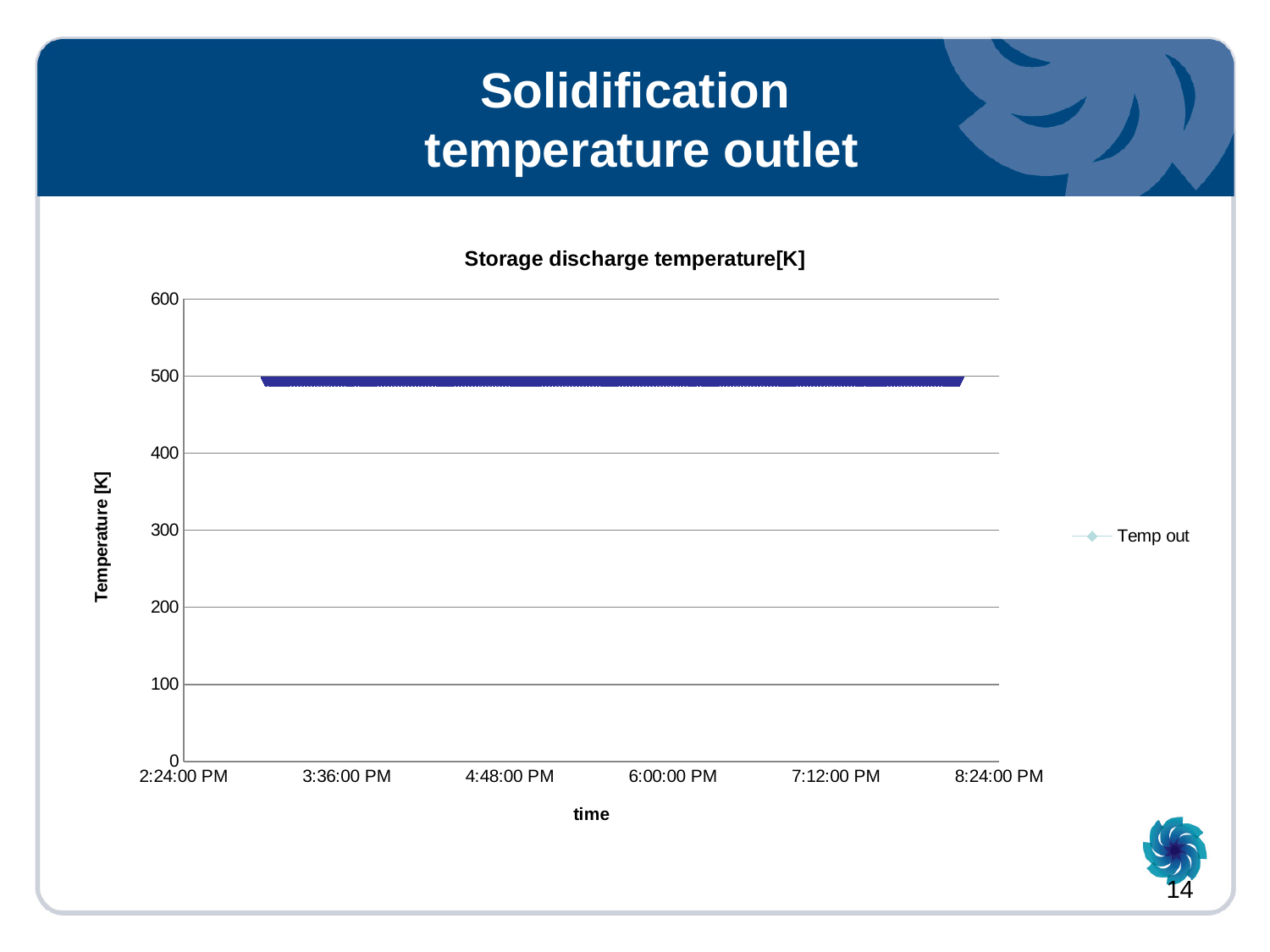
What kind of chart is shown on the slide? line chart What is the title of the chart? Storage discharge temperature[K] What is the highest value shown on the vertical axis? 600 Is the Temp out value at 4:48:00 PM greater or less than 400? greater Is the Temp out value at 6:00:00 PM greater or less than 600? less What is the label of the vertical axis? Temperature [K] How many series does the chart legend list? 1 Do the Temp out values rise, fall, or stay roughly constant over time? stay roughly constant Is the Temp out value at 7:12:00 PM greater or less than 300? greater